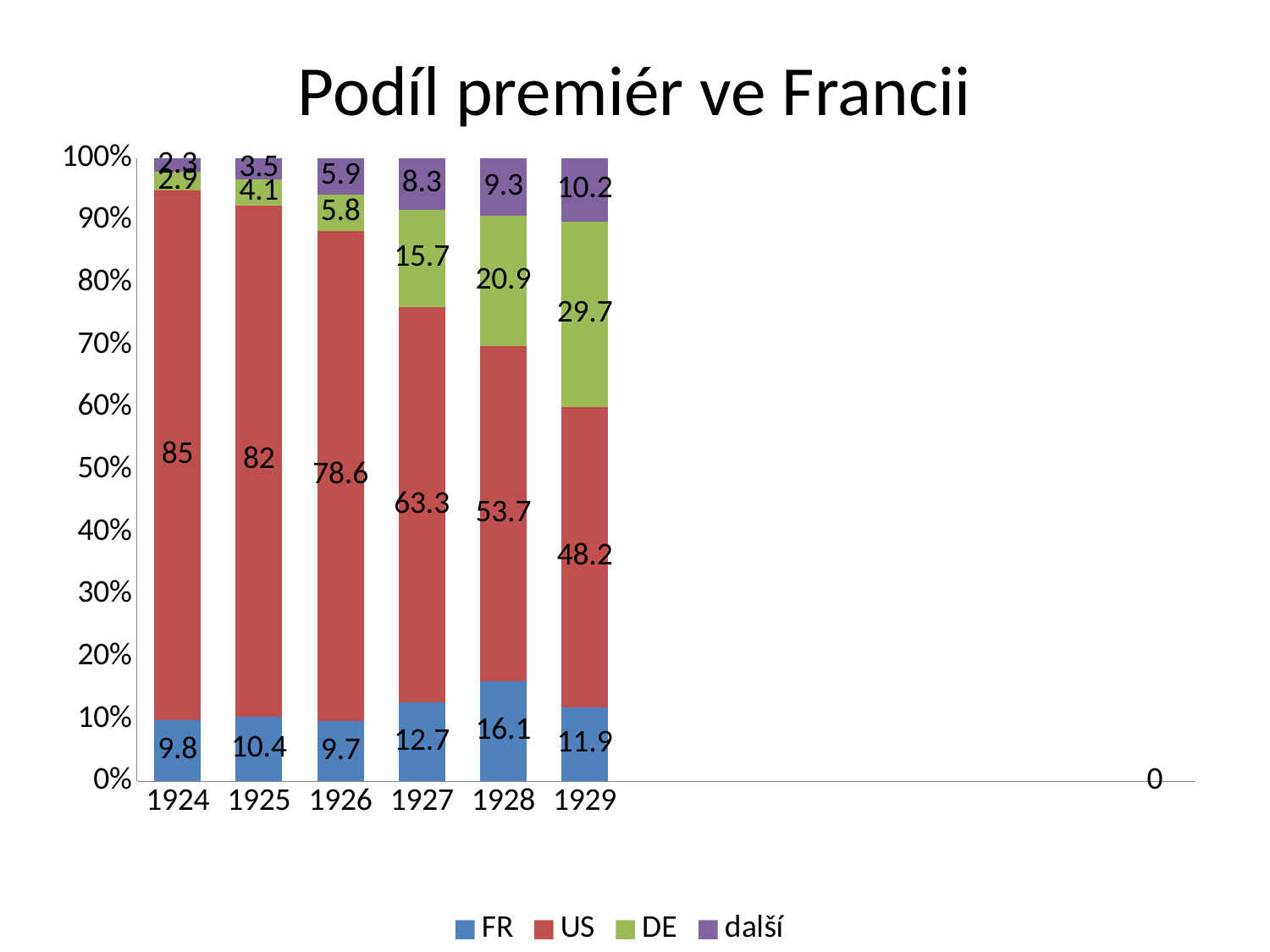
What is the title of the chart? Podíl premiér ve Francii Which is larger, the DE value for 1929 or the FR value for 1929? DE (29.7) Does the US share rise or fall from 1924 to 1929? Fall In which year is the US share highest? 1924 What kind of chart is shown? Stacked bar chart What is the difference between the US values for 1924 and 1929? 36.8 What is the 'další' value for 1927? 8.3 In which year is the DE share lowest? 1924 What is the FR value for 1925? 10.4 How many series does the legend list? 4 What is the DE value for 1928? 20.9 What is the US value for 1929? 48.2